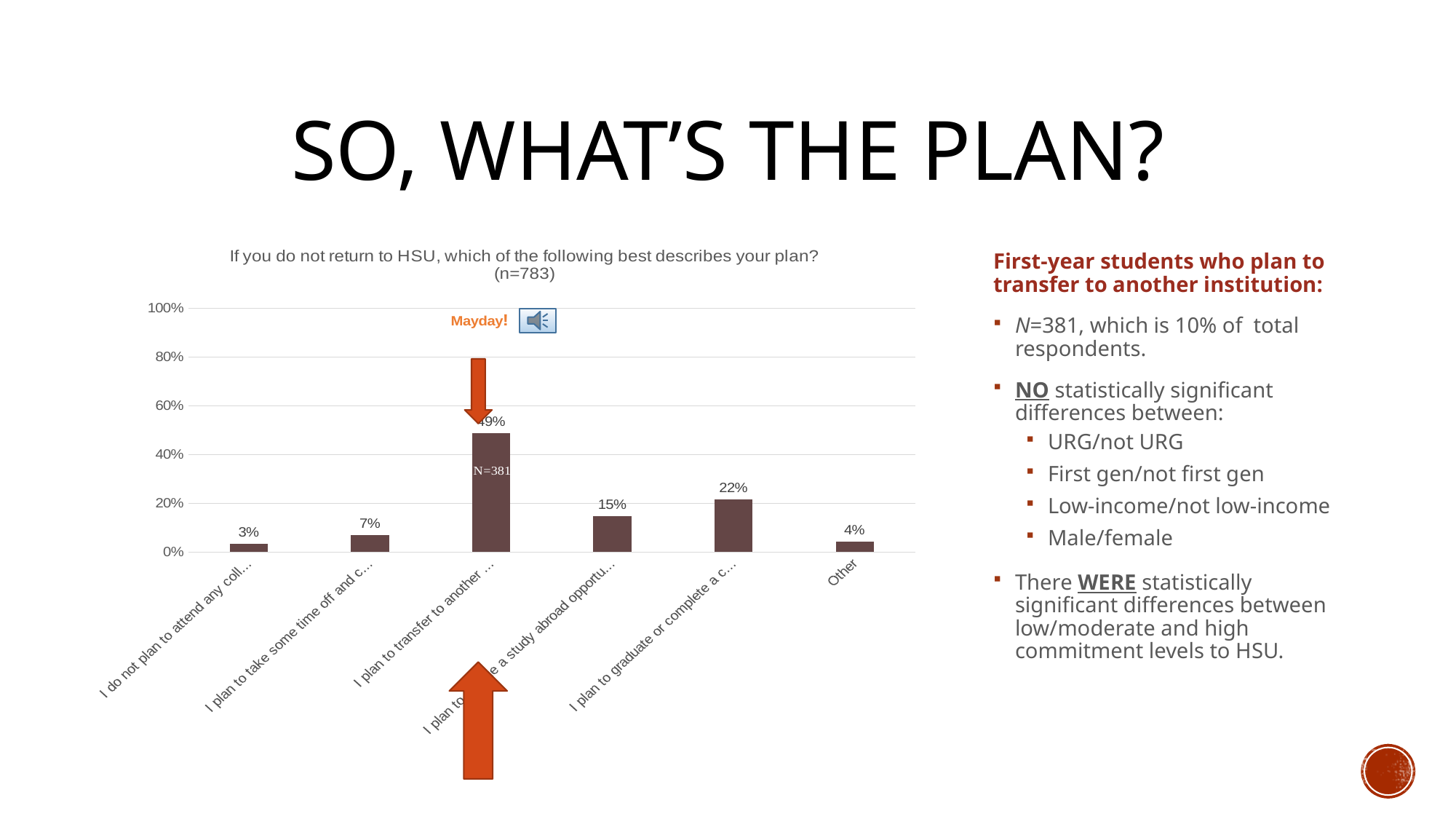
What is the value for the study abroad category? 15% What is the value for the category "I do not plan to attend any coll..."? 3% What sample size (n) is given in the chart title? n=783 What is the difference between the value for "I plan to graduate or complete a c..." and the study abroad category? 7 percentage points What is the value for the category "I plan to graduate or complete a c..."? 22% How many categories (bars) does the chart show? 6 What is the value for the "Other" category? 4% What is the value for the category "I plan to take some time off and c..."? 7% Which is larger: the value for "Other" or the value for "I plan to take some time off and c..."? I plan to take some time off and c... Which category has the highest value? I plan to transfer to another ... What kind of chart is shown on the slide? bar chart Which category has the lowest value? I do not plan to attend any coll...